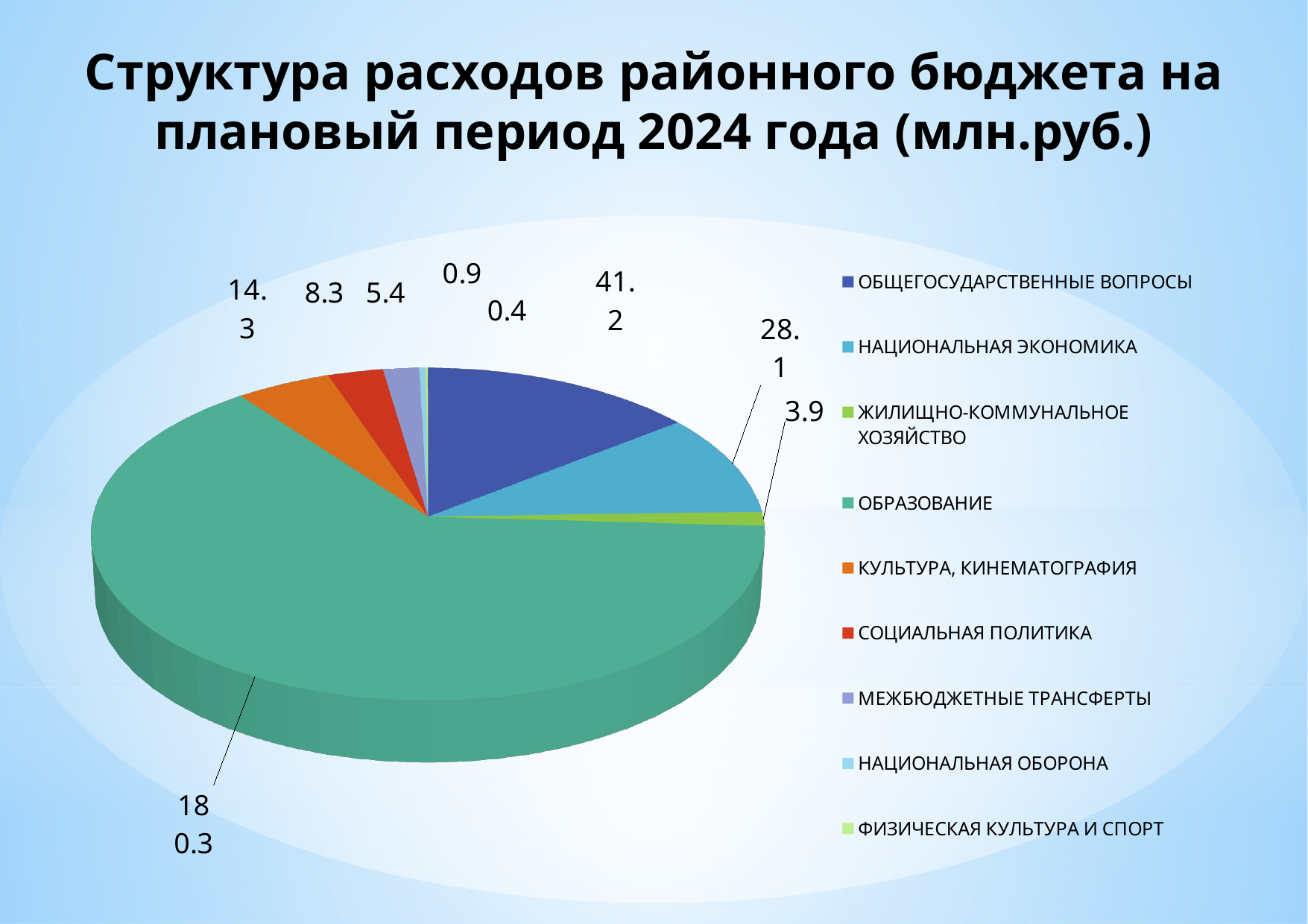
How many categories does the legend list? 9 What is the title of the chart on the slide? Структура расходов районного бюджета на плановый период 2024 года (млн.руб.) Which category has the largest slice of the pie? ОБРАЗОВАНИЕ What is the value for КУЛЬТУРА, КИНЕМАТОГРАФИЯ? 14.3 Which is larger, the value for КУЛЬТУРА, КИНЕМАТОГРАФИЯ or the value for СОЦИАЛЬНАЯ ПОЛИТИКА? КУЛЬТУРА, КИНЕМАТОГРАФИЯ Which category has the smallest slice of the pie? ФИЗИЧЕСКАЯ КУЛЬТУРА И СПОРТ What is the value for ОБЩЕГОСУДАРСТВЕННЫЕ ВОПРОСЫ? 41.2 What is the value for СОЦИАЛЬНАЯ ПОЛИТИКА? 8.3 What type of chart is shown on the slide? pie chart What is the value for ОБРАЗОВАНИЕ? 180.3 What is the value for НАЦИОНАЛЬНАЯ ЭКОНОМИКА? 28.1 What is the difference between the values for ОБЩЕГОСУДАРСТВЕННЫЕ ВОПРОСЫ and НАЦИОНАЛЬНАЯ ЭКОНОМИКА? 13.1